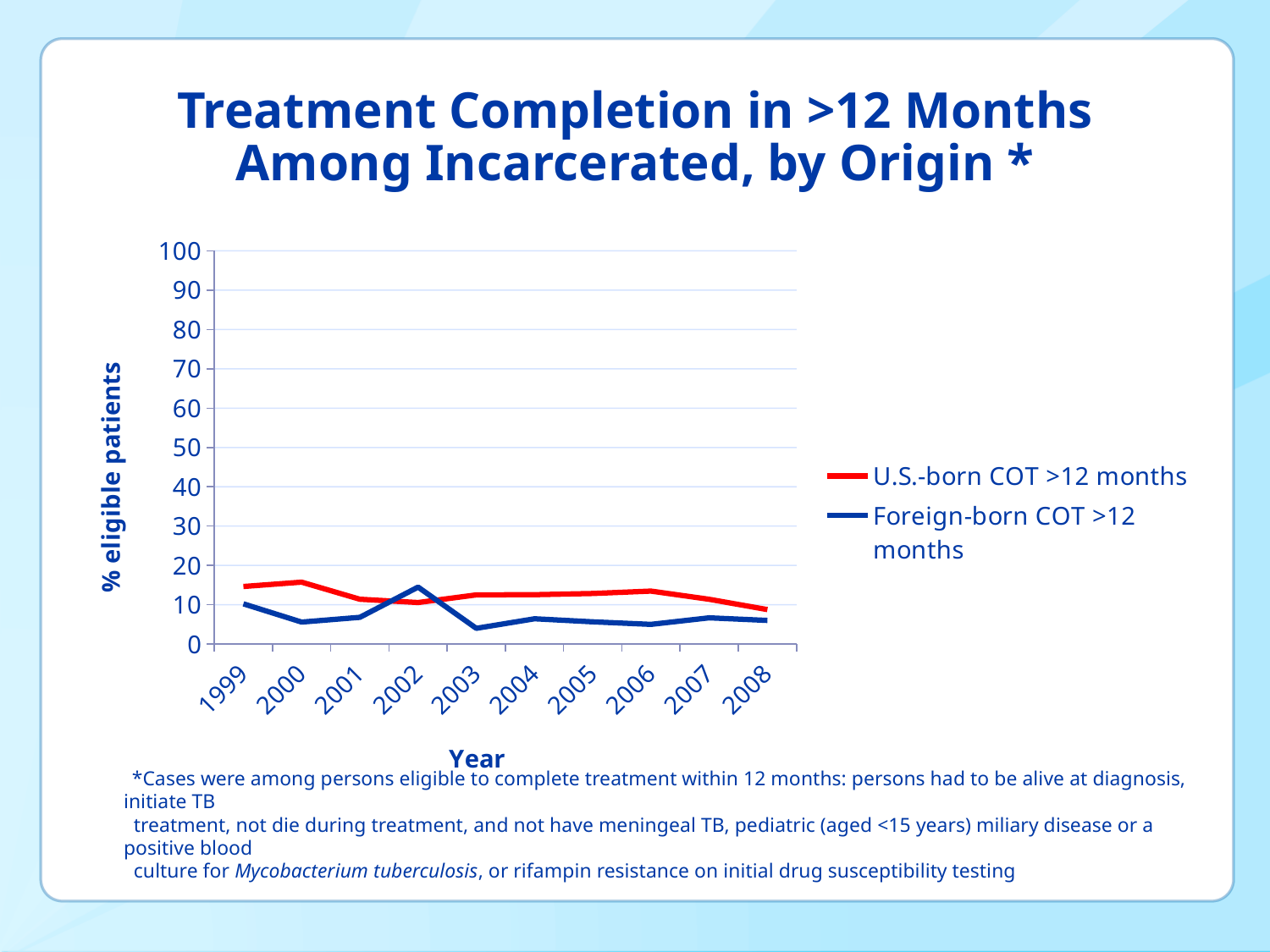
What kind of chart is shown on the slide? line chart Is the value for U.S.-born COT >12 months in 2006 greater or less than 20? less Which colour is used for the U.S.-born COT >12 months line? red How many years are plotted along the x axis? 10 Is the value for U.S.-born COT >12 months in 2000 greater or less than 10? greater In 2002, which series has the larger value, U.S.-born COT >12 months or Foreign-born COT >12 months? Foreign-born COT >12 months Is the value for Foreign-born COT >12 months in 2003 greater or less than 10? less In 2000, which series has the larger value, U.S.-born COT >12 months or Foreign-born COT >12 months? U.S.-born COT >12 months In which year does the Foreign-born COT >12 months series reach its highest value? 2002 What is the label on the y axis? % eligible patients How many series does the legend list? 2